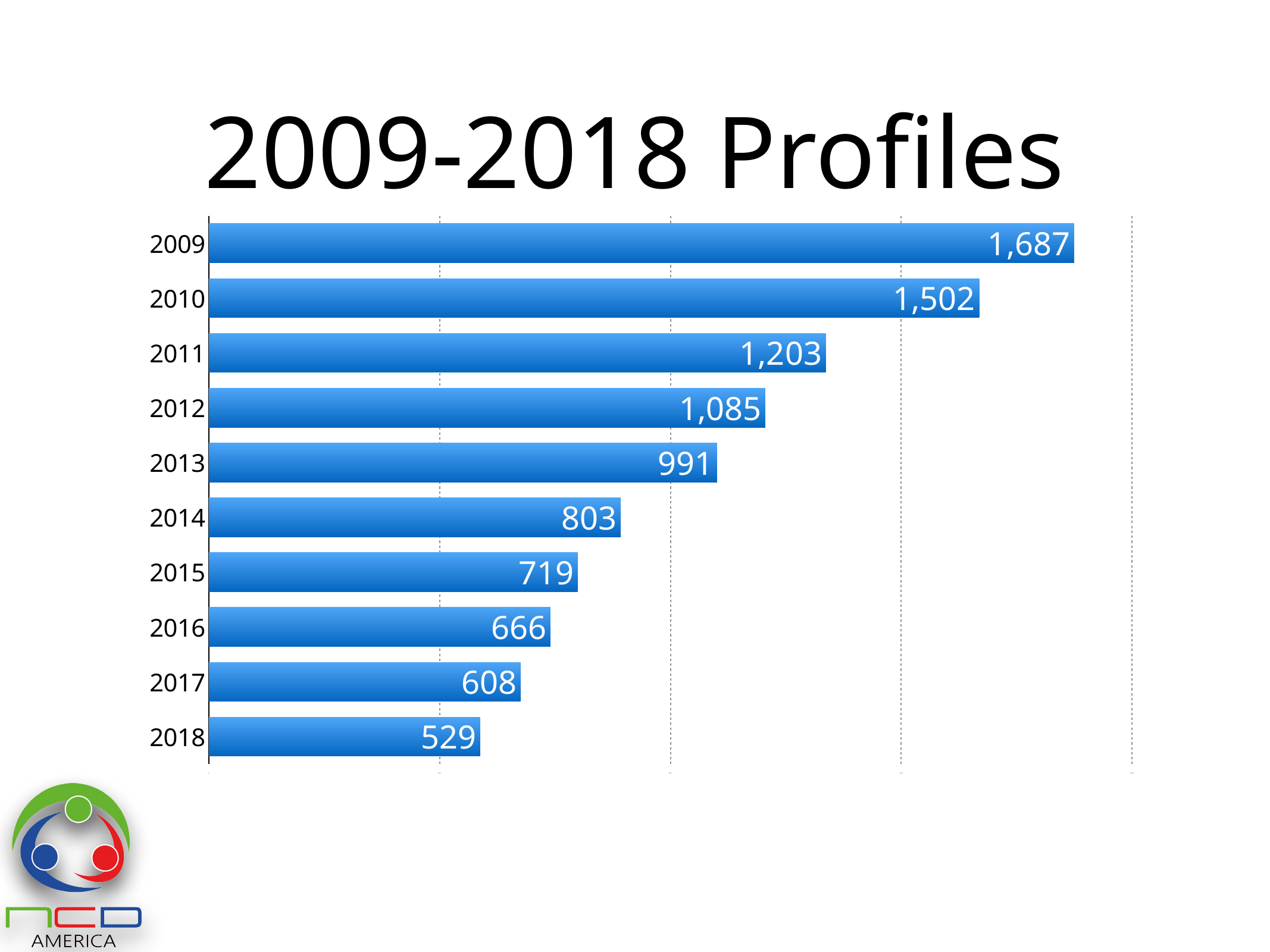
Do the values rise or fall from 2009 to 2018? Fall Which year has the lowest value? 2018 Which is larger, the value for 2012 or the value for 2014? 2012 Which year has the highest value? 2009 What is the value for 2015? 719 What kind of chart is shown on the slide? Bar chart What is the value for 2013? 991 What is the difference between the values for 2009 and 2010? 185 What is the difference between the values for 2016 and 2017? 58 How many years are shown in the chart? 10 What is the value for 2018? 529 What is the value for 2009? 1,687